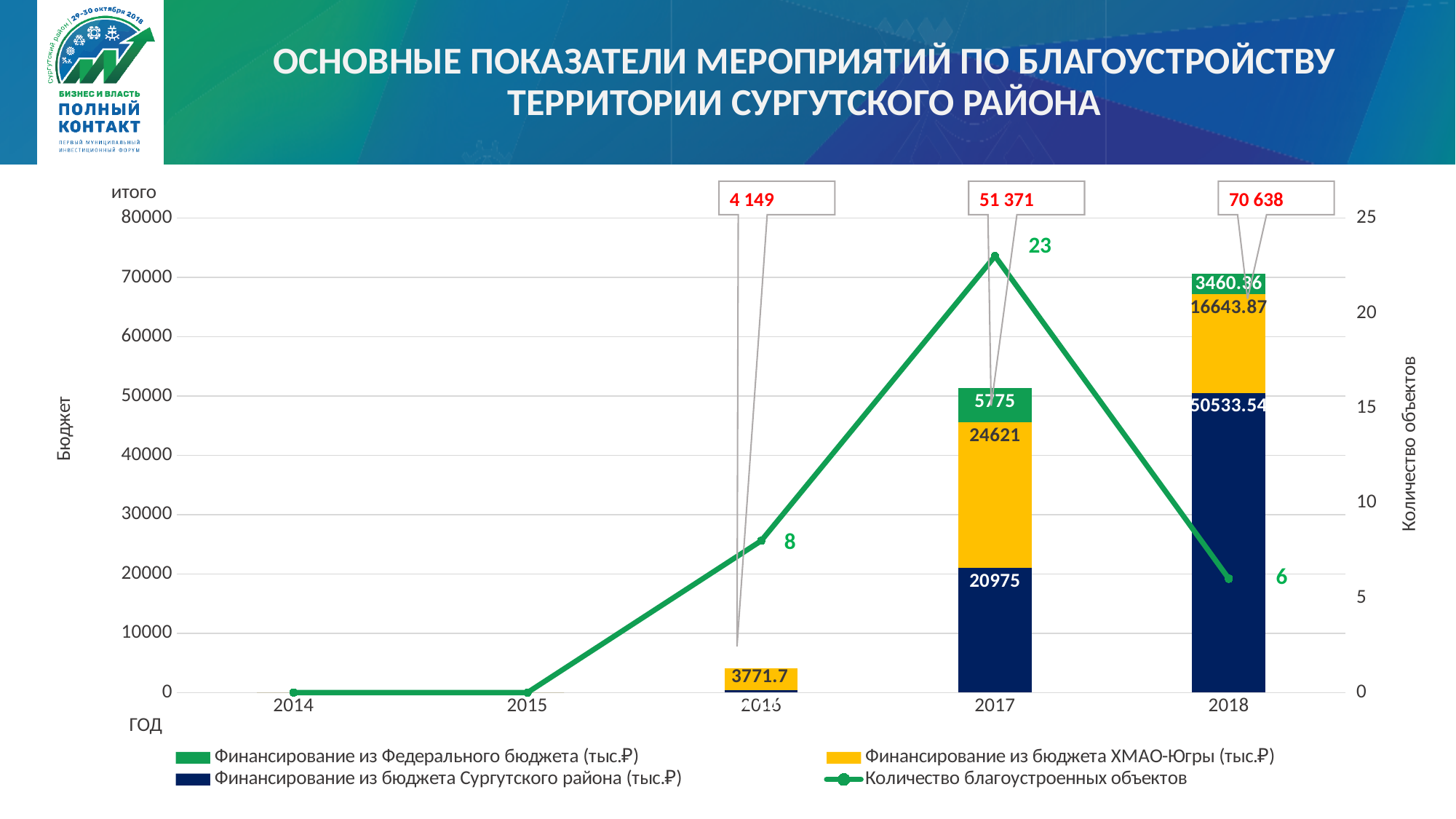
Does the number of improved objects rise or fall from 2017 to 2018? fall How many years are shown on the x axis? 5 In which year is the number of improved objects (Количество благоустроенных объектов) highest? 2017 Which is larger: financing from the Federal budget in 2017 or in 2018? 2017 What is the value of financing from the Federal budget (Финансирование из Федерального бюджета) in 2017? 5775 What is the difference between financing from the KhMAO-Yugra budget in 2017 and in 2018? 7977.13 What is the value of financing from the Surgut district budget (Финансирование из бюджета Сургутского района) in 2017? 20975 What is the value of financing from the KhMAO-Yugra budget (Финансирование из бюджета ХМАО-Югры) in 2018? 16643.87 How many series does the legend list? 4 How many improved objects (Количество благоустроенных объектов) are shown for 2017? 23 Which year has the largest financing from the Surgut district budget (Финансирование из бюджета Сургутского района)? 2018 What is the total (итого) shown for 2018? 70 638